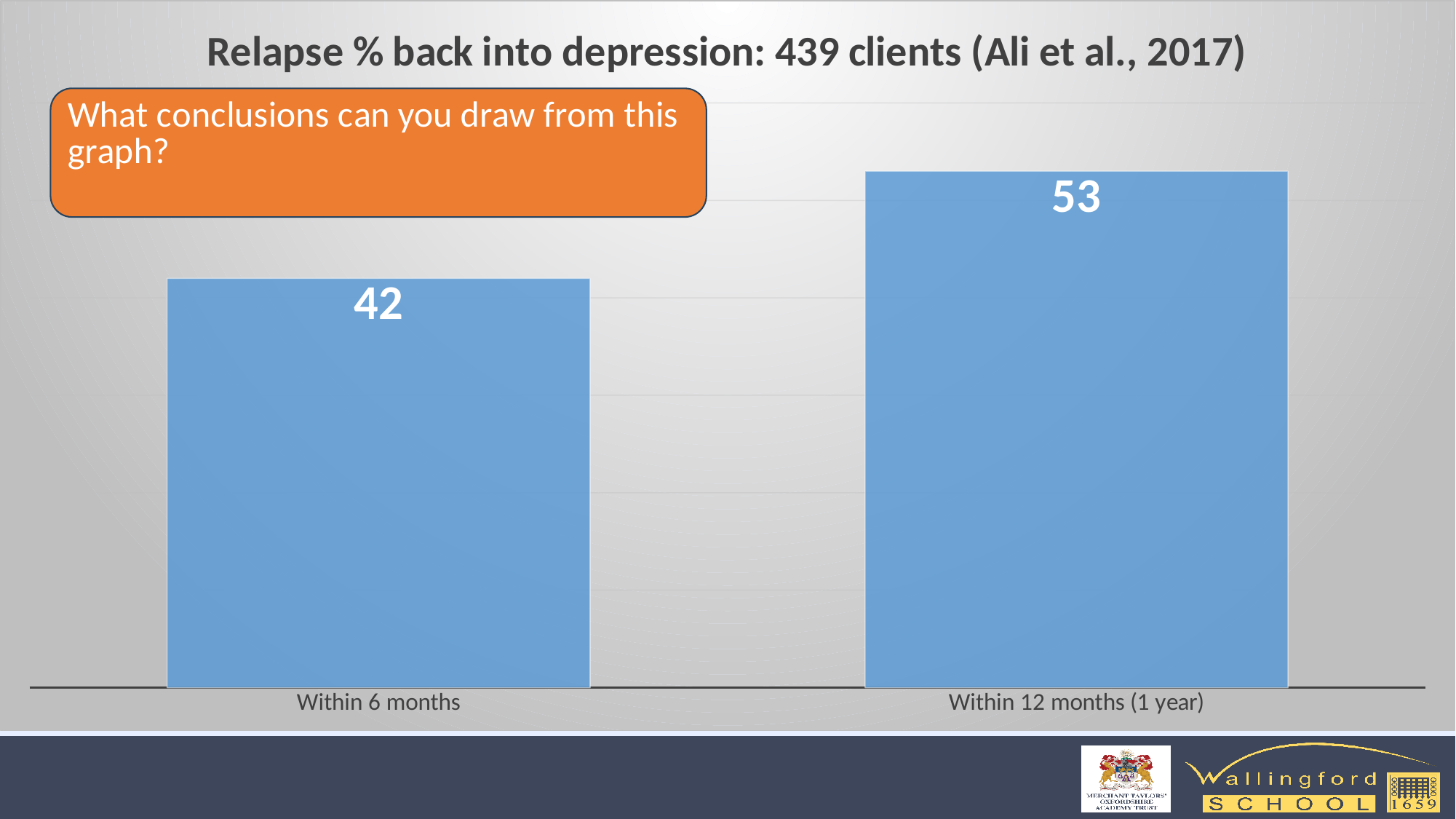
What is the relapse value for 'Within 6 months'? 42 Which category has the lowest value? Within 6 months Which is larger: the value for 'Within 6 months' or 'Within 12 months (1 year)'? Within 12 months (1 year) What is the difference between the values for 'Within 12 months (1 year)' and 'Within 6 months'? 11 What colour are the bars in the chart? Blue What kind of chart is shown on the slide? Bar chart What is the title of the chart? Relapse % back into depression: 439 clients (Ali et al., 2017) How many categories are shown in the chart? 2 Which category has the highest value? Within 12 months (1 year) What is the relapse value for 'Within 12 months (1 year)'? 53 Do the values rise or fall from 'Within 6 months' to 'Within 12 months (1 year)'? Rise